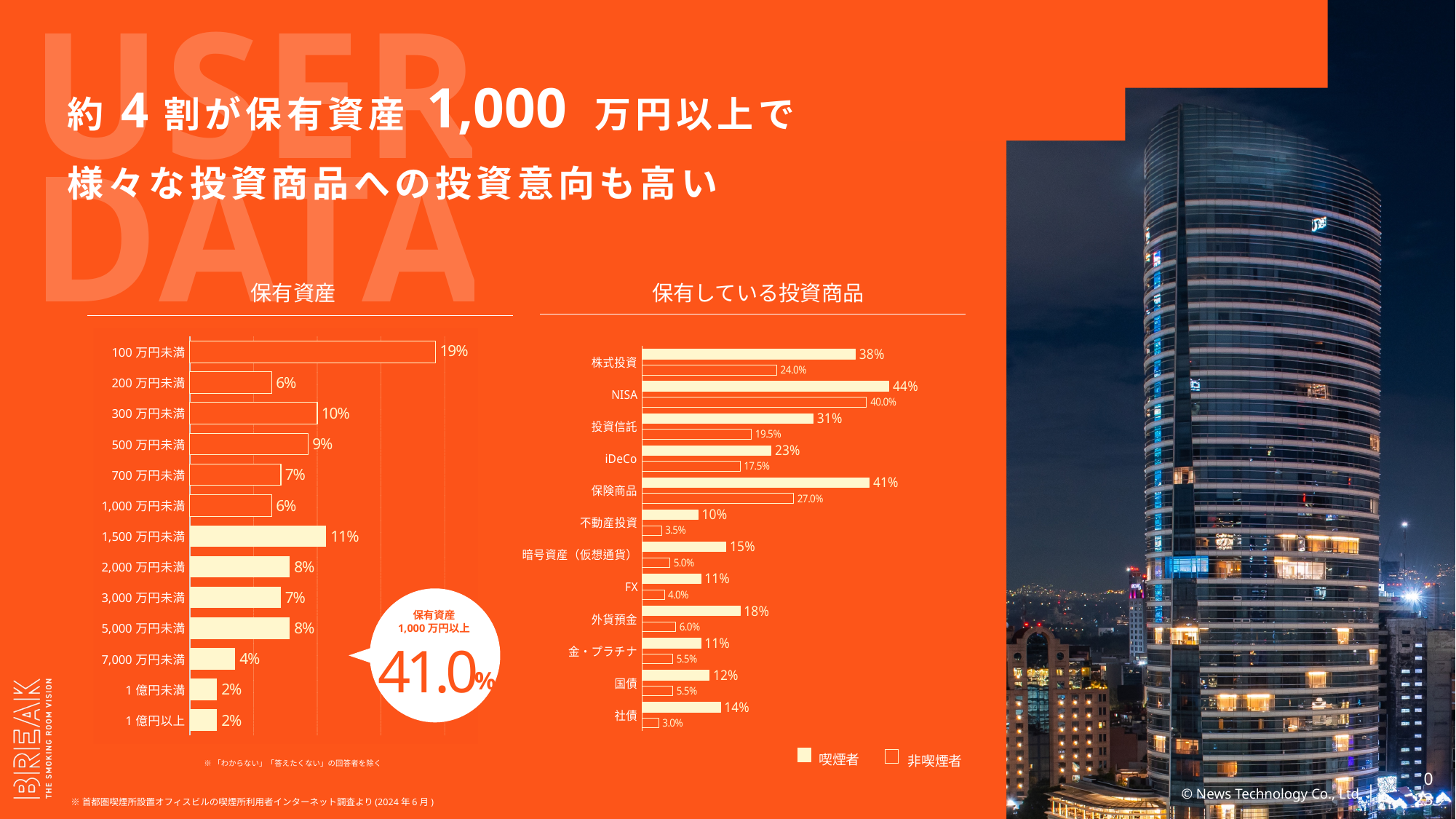
How many categories does the 保有資産 chart show? 13 In the 保有している投資商品 chart, what is the 非喫煙者 value for 保険商品? 27.0% In the 保有している投資商品 chart, what is the difference between the 喫煙者 and 非喫煙者 values for 投資信託? 11.5% In the 保有している投資商品 chart, what is the 喫煙者 value for NISA? 44% In the 保有している投資商品 chart, which category has the lowest 非喫煙者 value? 社債 In the 保有資産 chart, what is the value for 100万円未満? 19% In the 保有している投資商品 chart, which is larger for 株式投資: the 喫煙者 value or the 非喫煙者 value? 喫煙者 What kind of chart is the 保有資産 chart? bar chart How many series does the legend of the 保有している投資商品 chart list? 2 In the 保有資産 chart, what is the difference between the values for 1,500万円未満 and 7,000万円未満? 7% How many categories does the 保有している投資商品 chart show? 12 In the 保有資産 chart, which category has the highest value? 100万円未満